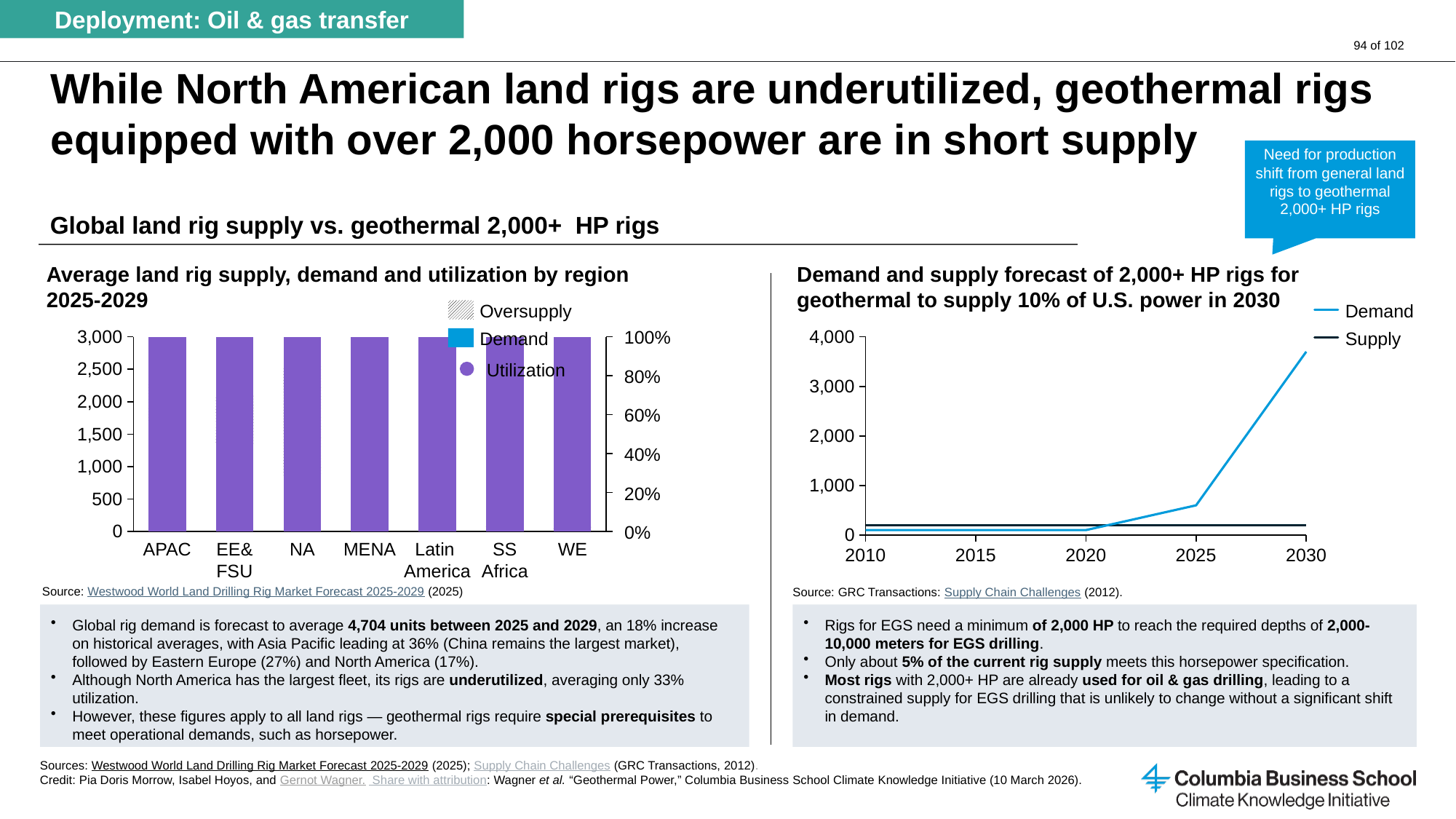
How many regions are shown on the x axis of the left chart, 'Average land rig supply, demand and utilization by region 2025-2029'? 7 What is the highest value shown on the left-hand axis of the left chart, 'Average land rig supply, demand and utilization by region 2025-2029'? 3,000 In the right chart, 'Demand and supply forecast of 2,000+ HP rigs', which series is higher in 2030, Demand or Supply? Demand In the right chart, 'Demand and supply forecast of 2,000+ HP rigs', is the Demand value in 2025 greater or less than 1,000? less How many years are labelled on the x axis of the right chart, 'Demand and supply forecast of 2,000+ HP rigs'? 5 In the right chart, 'Demand and supply forecast of 2,000+ HP rigs', is the Supply value in 2030 greater or less than 1,000? less How many series does the legend of the right chart, 'Demand and supply forecast of 2,000+ HP rigs', list? 2 What kind of chart is the left chart, 'Average land rig supply, demand and utilization by region 2025-2029'? Bar chart In the right chart, 'Demand and supply forecast of 2,000+ HP rigs', does the Demand line rise or fall between 2020 and 2030? Rise What kind of chart is the right chart, 'Demand and supply forecast of 2,000+ HP rigs for geothermal to supply 10% of U.S. power in 2030'? Line chart How many entries does the legend of the left chart, 'Average land rig supply, demand and utilization by region 2025-2029', list? 3 In the right chart, 'Demand and supply forecast of 2,000+ HP rigs', is the Demand value in 2030 greater or less than 3,000? greater